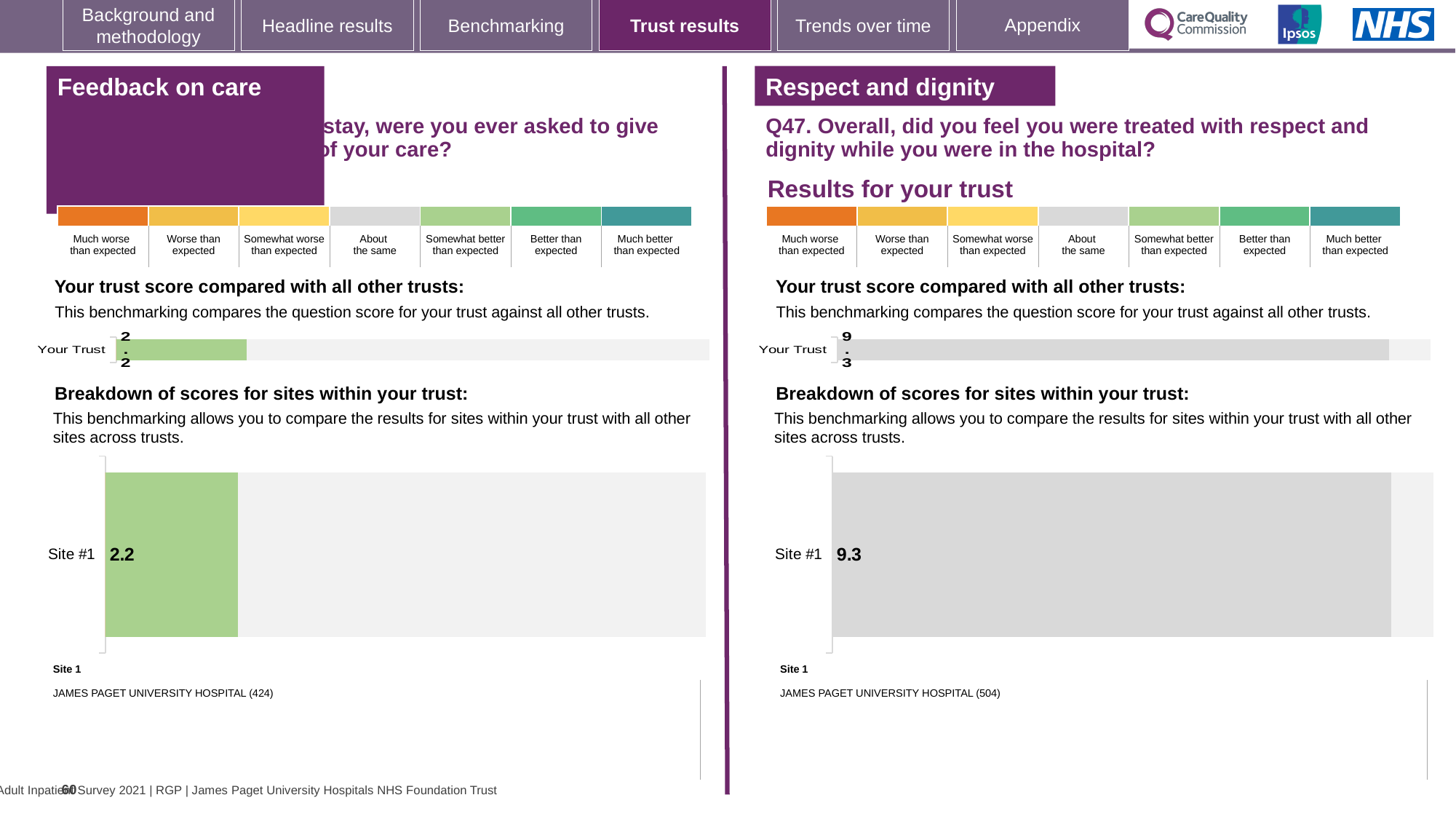
On the Feedback on care breakdown chart, what is the score for Site #1? 2.2 What kind of chart is used to show the Your Trust score on the Respect and dignity panel? Bar chart How many categories does the colour key above the Respect and dignity chart list? 7 On the Respect and dignity chart, what is the score shown for Your Trust? 9.3 On the Feedback on care chart, what is the score shown for Your Trust? 2.2 What colour is the Site #1 bar on the Feedback on care breakdown chart? Light green What is the difference between the Your Trust score on the Respect and dignity chart and the Your Trust score on the Feedback on care chart? 7.1 Which chart shows the higher Site #1 score, Feedback on care or Respect and dignity? Respect and dignity Is the Your Trust score on the Respect and dignity chart greater or less than 9? greater Which hospital is listed as Site 1 on the Respect and dignity panel? JAMES PAGET UNIVERSITY HOSPITAL On the Respect and dignity breakdown chart, what is the score for Site #1? 9.3 How many sites are shown in the Feedback on care breakdown chart? 1